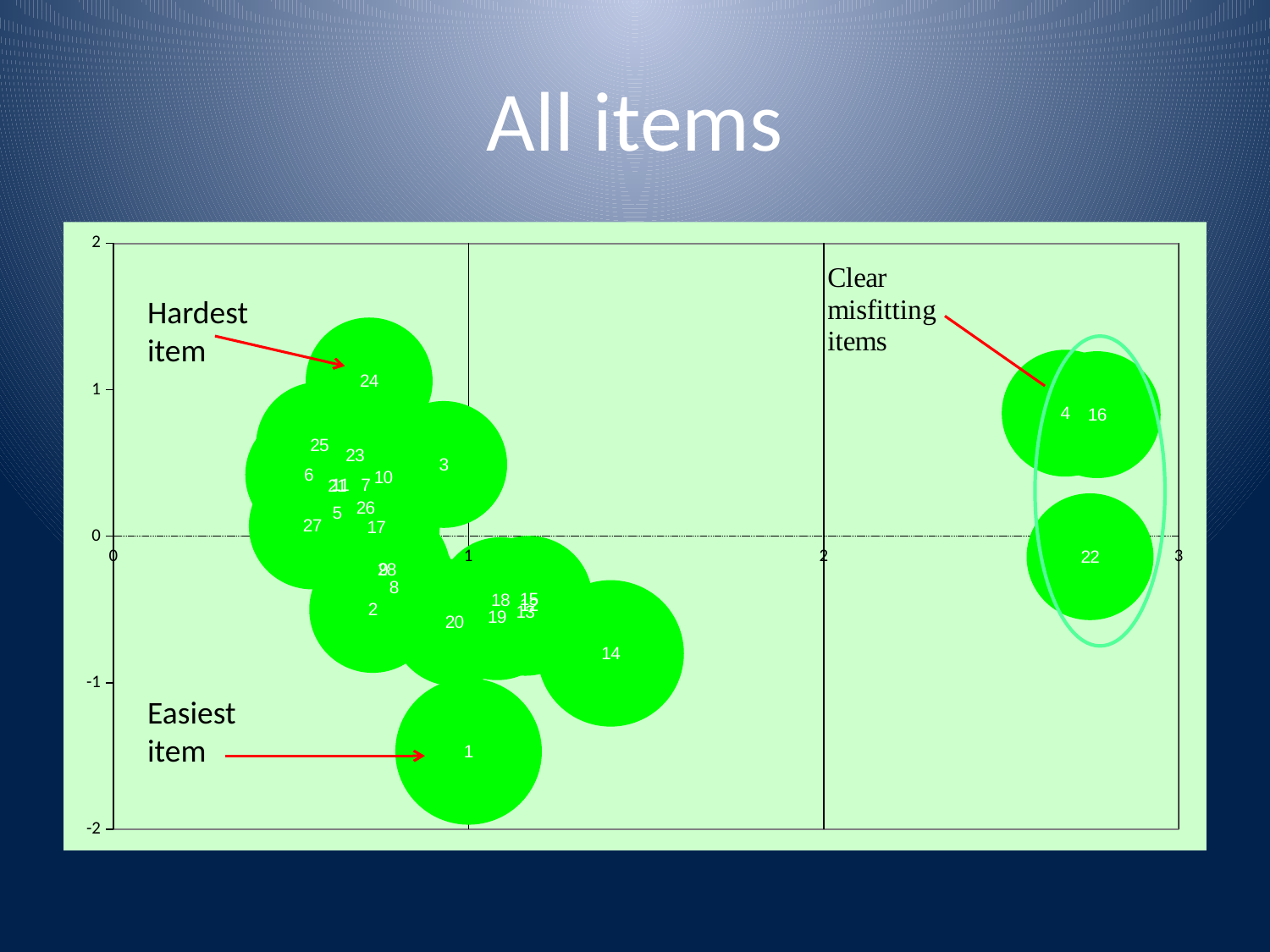
Which items are circled as clear misfitting items? 4, 16 and 22 Which item has the lowest vertical position on the chart? 1 Is the vertical value for item 1 greater or less than -1? less Is the vertical value for item 16 greater or less than 0? greater Is the horizontal value for item 24 greater or less than 1? less Which is positioned lower on the chart, item 1 or item 14? 1 Which item is annotated as the hardest item? 24 Which item has the highest vertical position on the chart? 24 Which is positioned further to the right on the chart, item 14 or item 22? 22 What kind of chart is shown on the slide? bubble chart